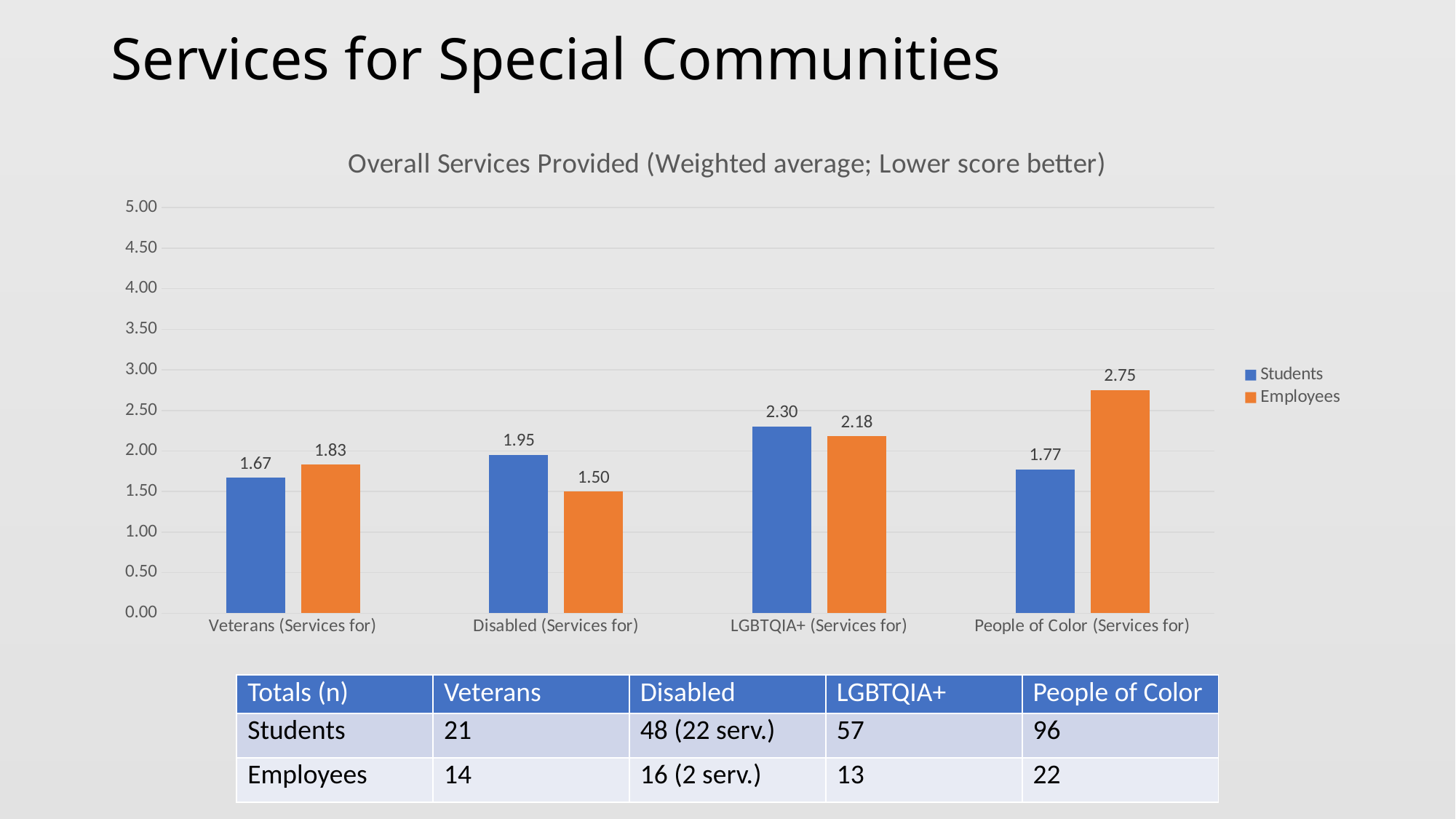
Which category has the highest Employees value? People of Color (Services for) How many series does the legend list? 2 What is the Employees value for Disabled (Services for)? 1.50 What is the difference between the Employees and Students values for People of Color (Services for)? 0.98 Which category has the lowest Students value? Veterans (Services for) What is the Students value for Veterans (Services for)? 1.67 What is the Employees value for People of Color (Services for)? 2.75 What is the Students value for LGBTQIA+ (Services for)? 2.30 How many categories are shown on the x axis? 4 What is the title of the chart? Overall Services Provided (Weighted average; Lower score better) What kind of chart is shown on the slide? Bar chart For Disabled (Services for), which series has the larger value, Students or Employees? Students